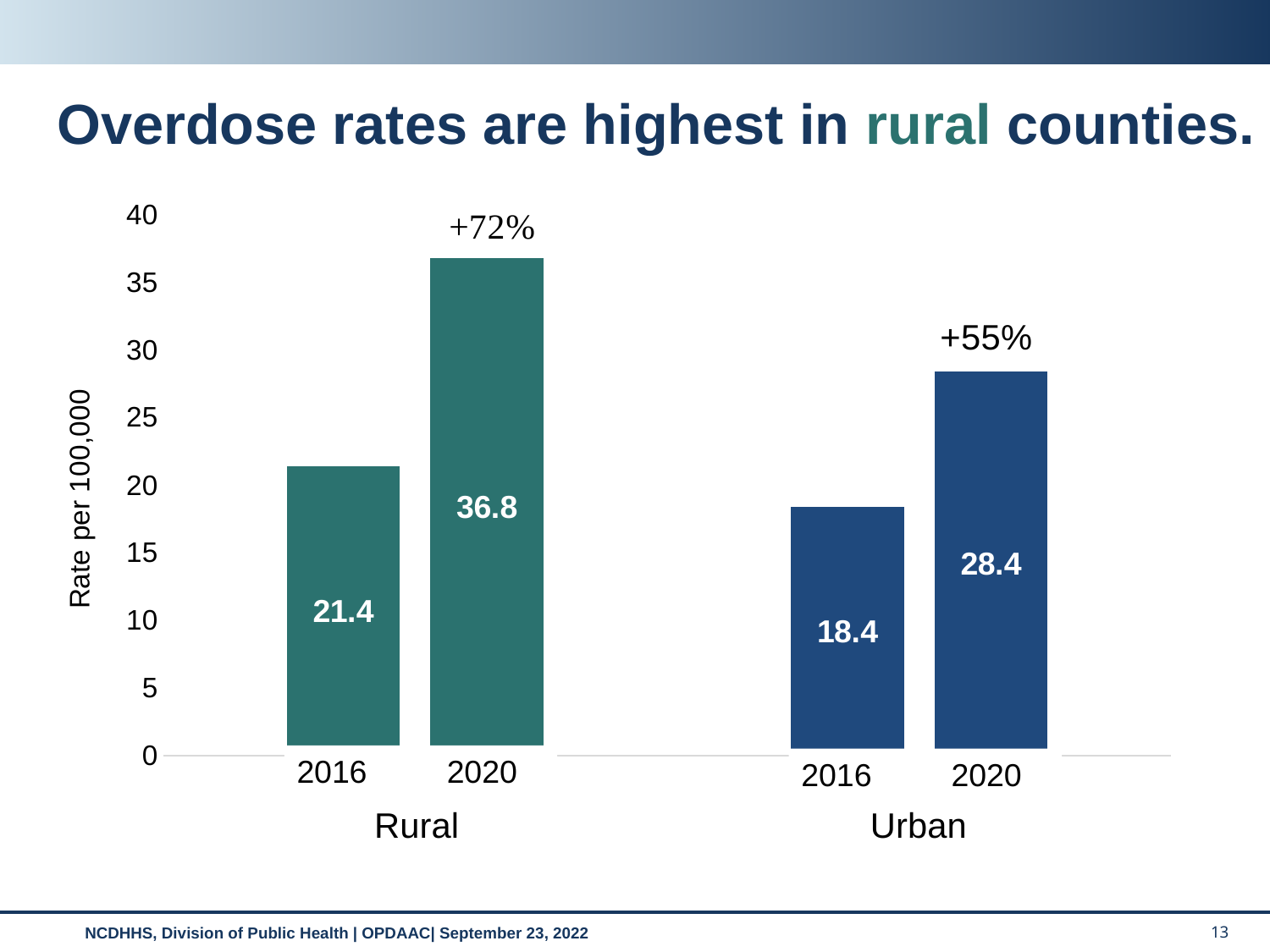
What percentage increase is shown above the Urban 2020 bar? +55% What is the difference between the Rural 2020 rate and the Rural 2016 rate? 15.4 What is the overdose rate per 100,000 for Urban counties in 2020? 28.4 What kind of chart is shown on the slide? Bar chart What is the difference between the Rural 2020 rate and the Urban 2020 rate? 8.4 What is the overdose rate per 100,000 for Urban counties in 2016? 18.4 What is the overdose rate per 100,000 for Rural counties in 2016? 21.4 Which is larger, the Rural 2016 rate or the Urban 2016 rate? Rural 2016 Which bar has the highest overdose rate? Rural 2020 What percentage increase is shown above the Rural 2020 bar? +72% What is the overdose rate per 100,000 for Rural counties in 2020? 36.8 Which bar has the lowest overdose rate? Urban 2016